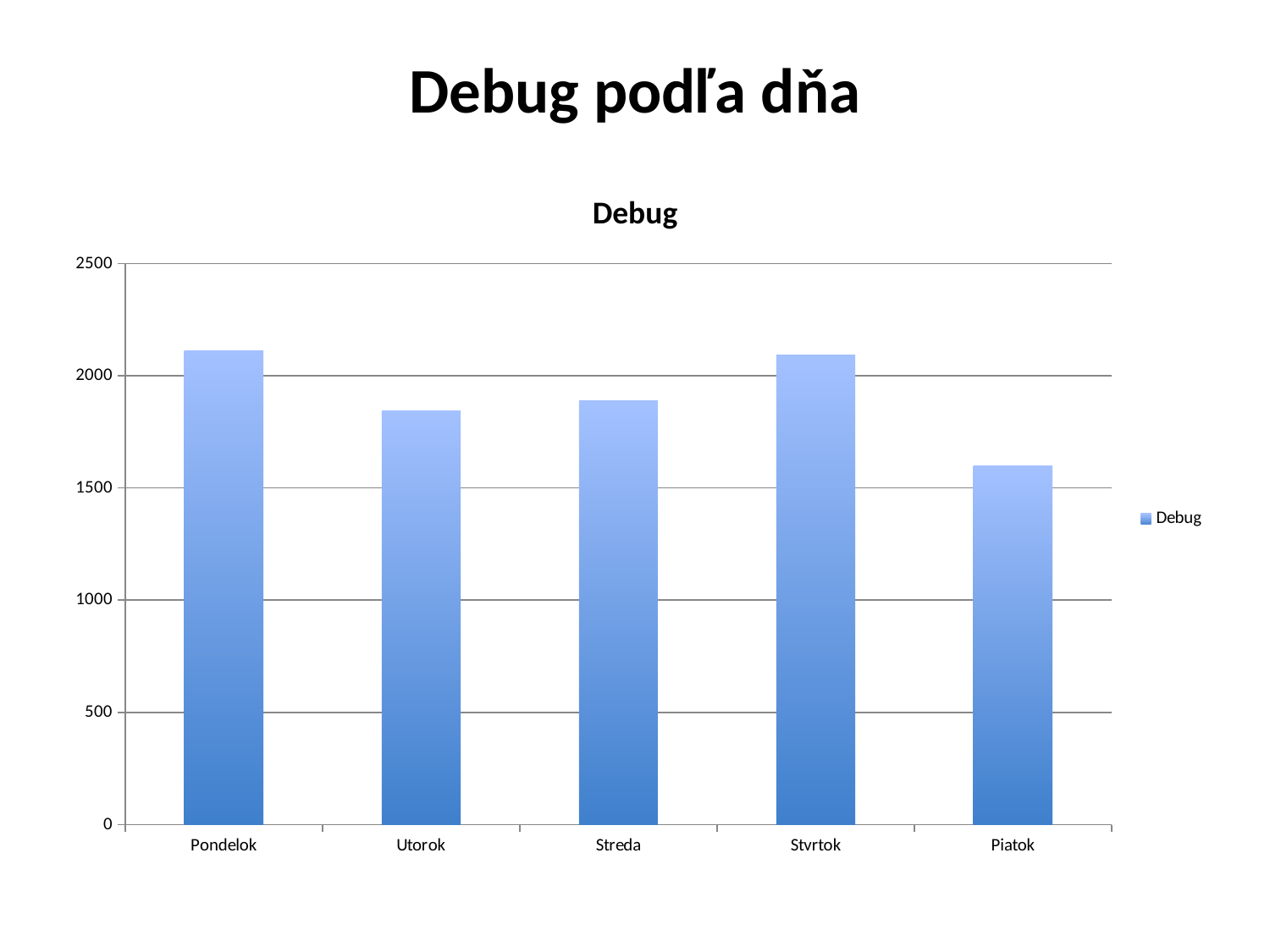
Is the value for Stvrtok greater or less than 2000? greater Is the value for Streda greater or less than 2000? less What kind of chart is shown on the slide? bar chart Is the value for Piatok greater or less than 1500? greater How many series does the legend list? 1 What is the title of the chart? Debug How many categories are shown on the x axis? 5 Which is larger, the value for Stvrtok or the value for Streda? Stvrtok Which day has the lowest value? Piatok Which is larger, the value for Utorok or the value for Piatok? Utorok